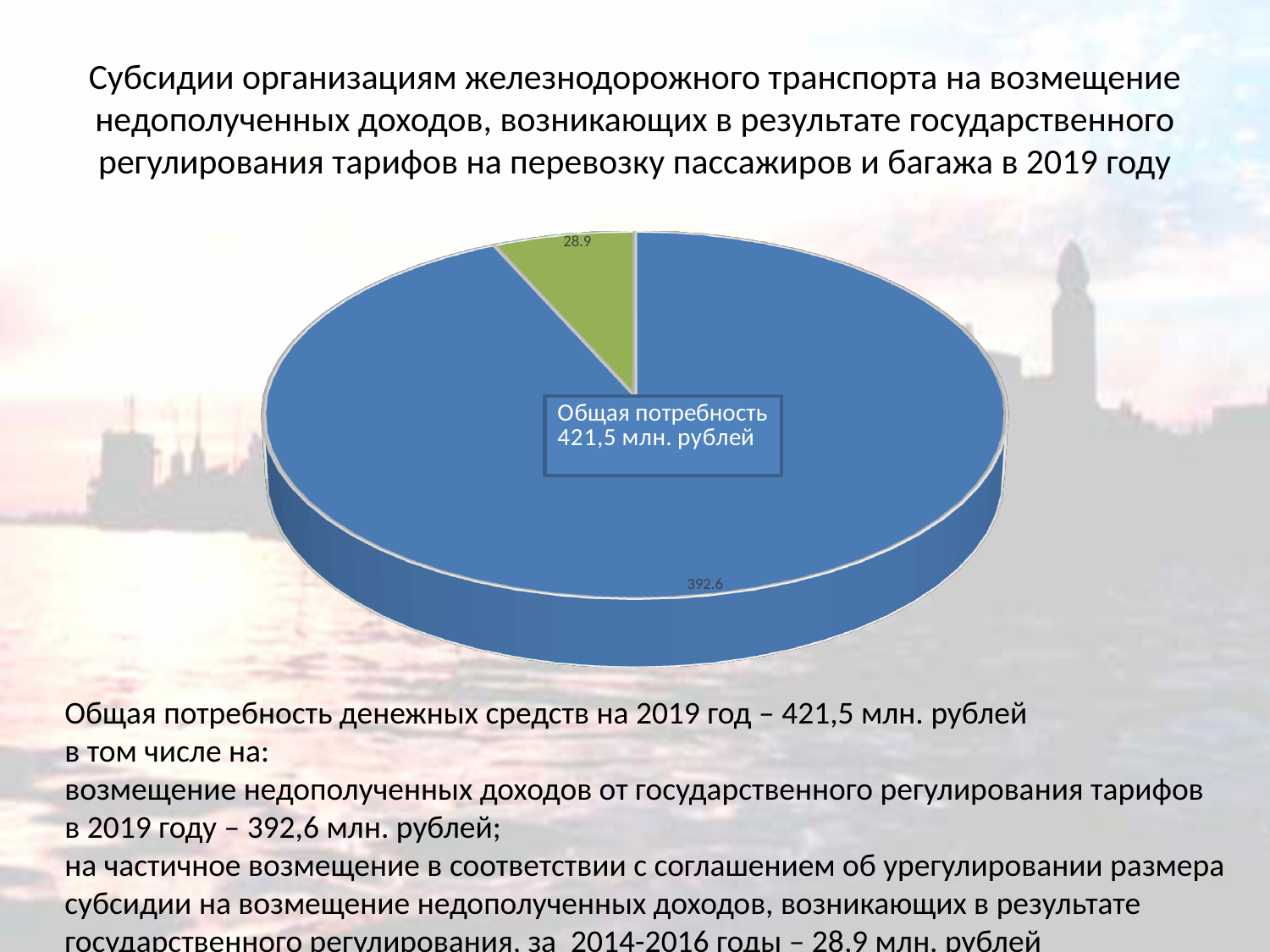
What kind of chart is shown on the slide? pie chart Which is larger: the blue slice or the green slice? the blue slice What colour is the slice representing 392.6? blue What value is printed on the green slice of the pie chart? 28.9 What is the difference between the values of the blue slice and the green slice? 363.7 Which slice of the pie chart is the smallest? the green slice (28.9) What value is printed on the blue slice of the pie chart? 392.6 What total amount (Общая потребность) is shown in the box on the pie chart? 421,5 млн. рублей What text is written in the box placed on the pie chart? Общая потребность 421,5 млн. рублей How many slices does the pie chart have? 2 Which slice of the pie chart is the largest? the blue slice (392.6)